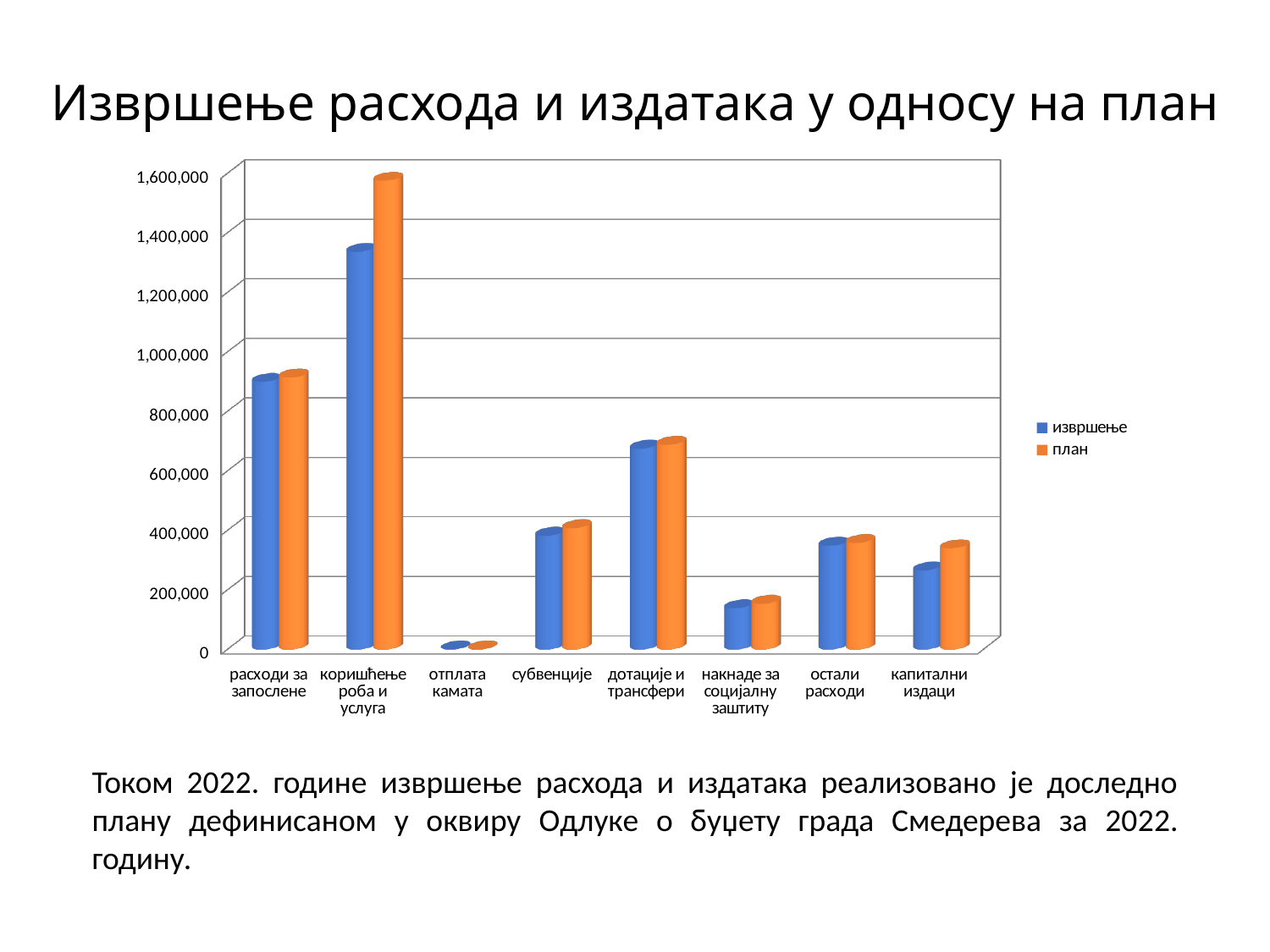
Which series is shown in orange in the legend? план Which category has the highest план value? коришћење роба и услуга How many series does the legend list? 2 How many categories are shown on the x axis of the chart? 8 What kind of chart is shown on the slide? bar chart Is the извршење value for капитални издаци greater or less than 400,000? less For коришћење роба и услуга, which is larger: извршење or план? план Is the извршење value for коришћење роба и услуга greater or less than 1,200,000? greater Is the план value for коришћење роба и услуга greater or less than 1,400,000? greater Which category has the lowest извршење value? отплата камата